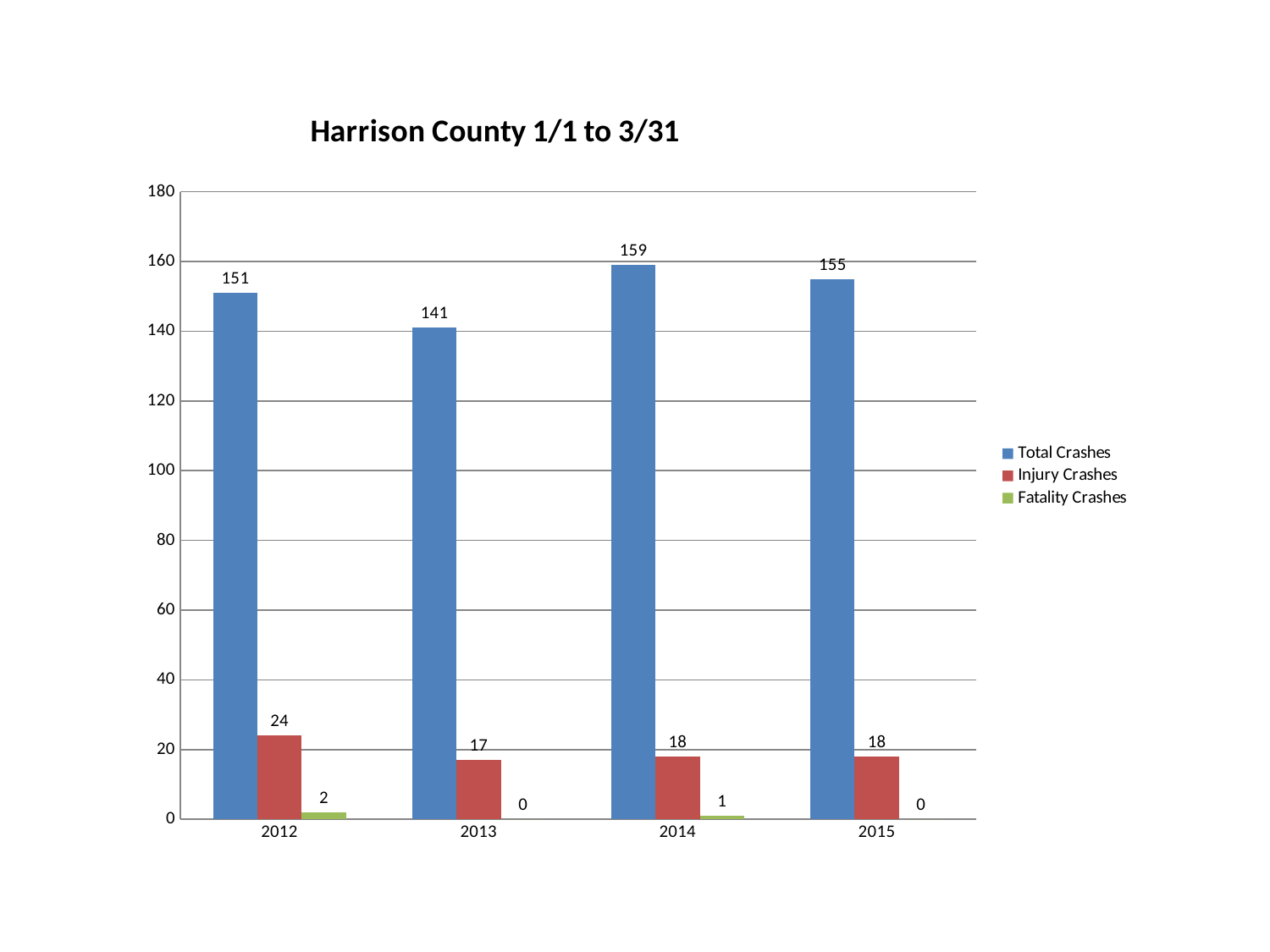
How many years are shown on the x axis? 4 What is the title of the chart? Harrison County 1/1 to 3/31 What is the value of Injury Crashes for 2012? 24 What is the value of Fatality Crashes for 2013? 0 Is the value of Total Crashes for 2015 greater or less than 140? greater What kind of chart is shown on the slide? bar chart Which year has the highest Total Crashes? 2014 Which is larger, Injury Crashes in 2012 or Injury Crashes in 2013? 2012 What is the difference between Total Crashes in 2014 and 2013? 18 What is the value of Total Crashes for 2014? 159 Which year has the lowest Total Crashes? 2013 How many series does the legend list? 3